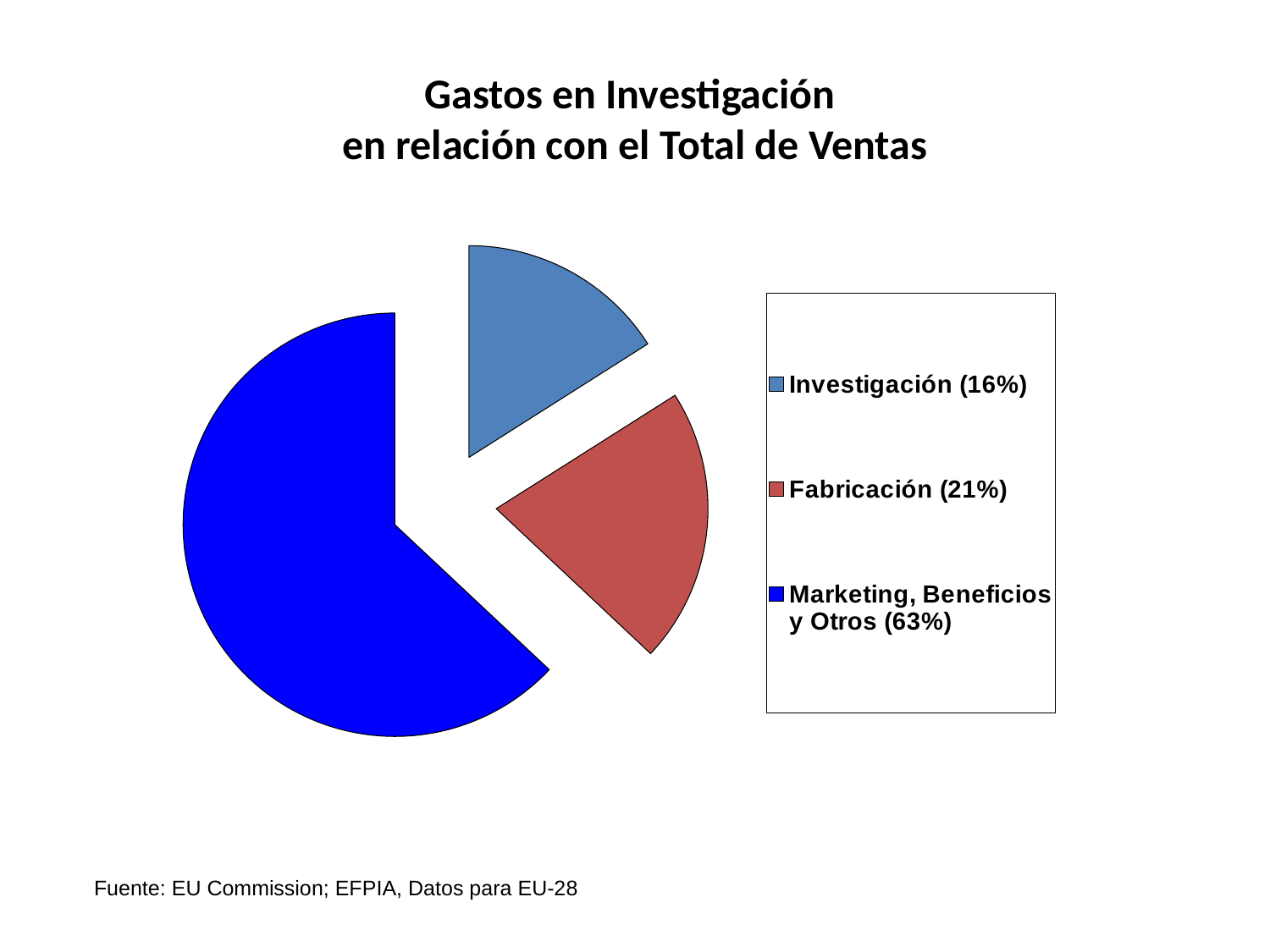
What share of the pie does Marketing, Beneficios y Otros represent? 63% Which category has the largest slice of the pie? Marketing, Beneficios y Otros Which category has the smallest slice of the pie? Investigación What share of the pie does Fabricación represent? 21% What is the difference in percentage points between Fabricación and Investigación? 5 What share of the pie does Investigación represent? 16% What is the difference in percentage points between Marketing, Beneficios y Otros and Fabricación? 42 Which is larger, the share for Fabricación or the share for Investigación? Fabricación What colour is the slice for Marketing, Beneficios y Otros? Blue What is the title of the chart? Gastos en Investigación en relación con el Total de Ventas What kind of chart is shown on the slide? Pie chart How many categories does the pie chart have? 3